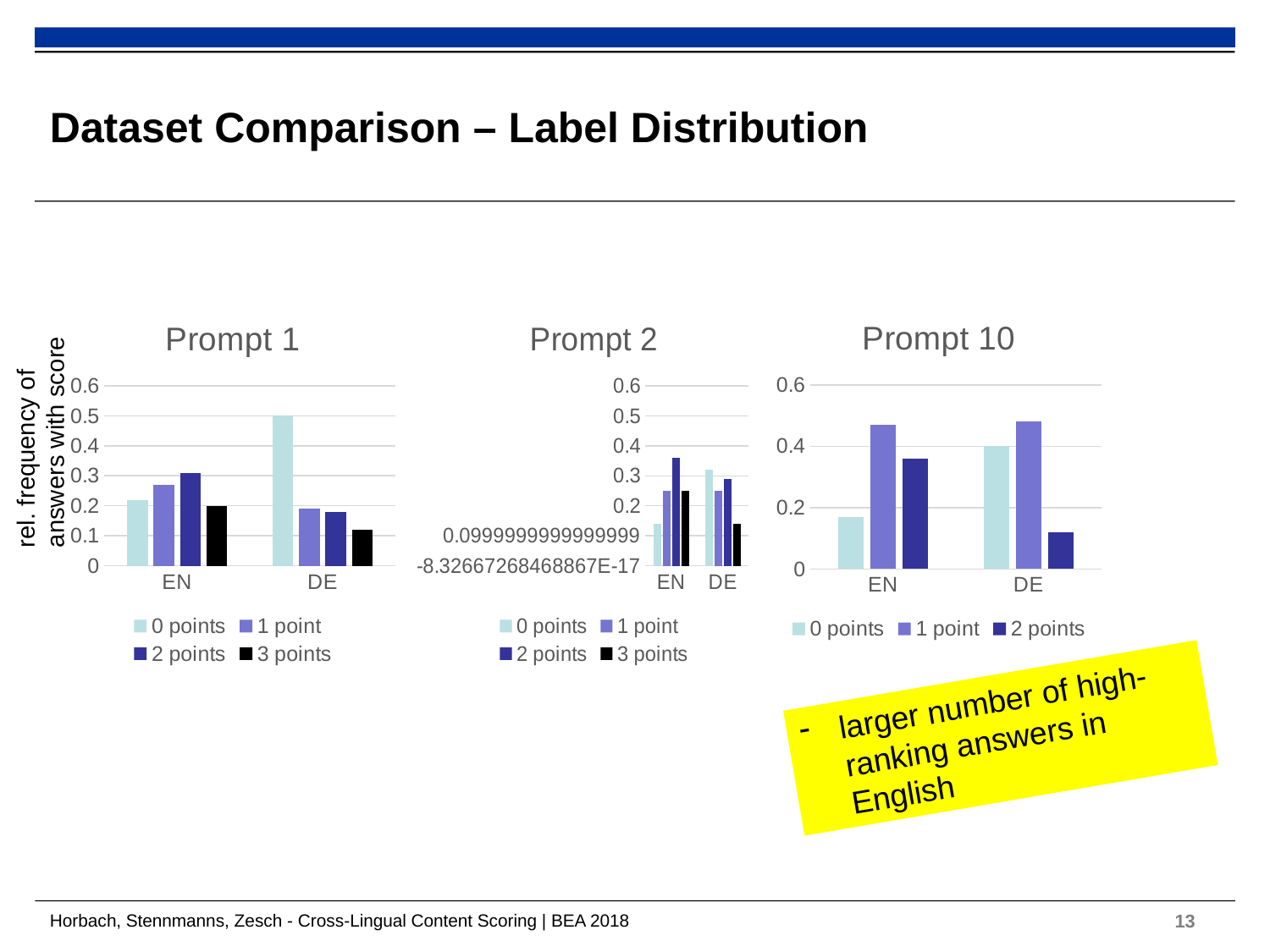
In the Prompt 10 chart, is the value for 2 points in DE greater or less than 0.2? less What is the label of the y axis shown to the left of the Prompt 1 chart? rel. frequency of answers with score How many series does the legend of the Prompt 10 chart list? 3 In the Prompt 2 chart, which is larger: the value for 2 points in EN or the value for 0 points in EN? 2 points in EN How many categories are shown on the x axis of the Prompt 2 chart? 2 In the Prompt 1 chart, which series has the lowest value for DE? 3 points In the Prompt 1 chart, is the value for 0 points in DE greater or less than 0.4? greater In the Prompt 1 chart, which series has the highest value for DE? 0 points What kind of chart is the Prompt 1 chart? bar chart In the Prompt 10 chart, which is larger: the value for 0 points in DE or the value for 0 points in EN? 0 points in DE In the Prompt 10 chart, is the value for 1 point in EN greater or less than 0.4? greater How many series does the legend of the Prompt 1 chart list? 4